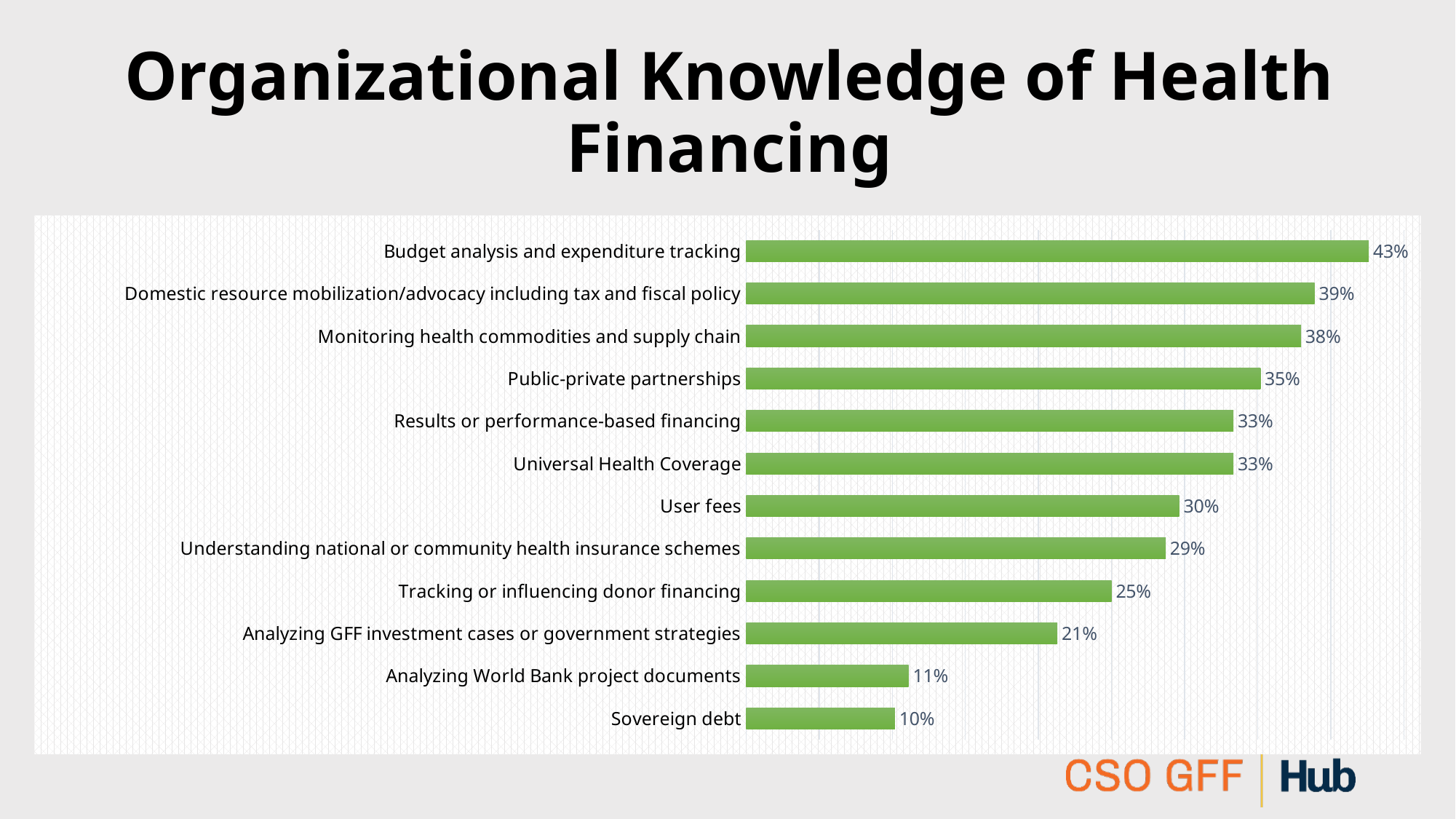
What is the value for Sovereign debt? 10% What is the value for Budget analysis and expenditure tracking? 43% What kind of chart is shown on the slide? Bar chart Which is larger, Monitoring health commodities and supply chain or Understanding national or community health insurance schemes? Monitoring health commodities and supply chain What is the difference between Budget analysis and expenditure tracking and Sovereign debt? 33% Which category has the lowest value? Sovereign debt What is the title of the slide? Organizational Knowledge of Health Financing What is the value for User fees? 30% How many categories are shown in the chart? 12 What is the difference between Public-private partnerships and Tracking or influencing donor financing? 10% Which category has the highest value? Budget analysis and expenditure tracking What is the value for Analyzing GFF investment cases or government strategies? 21%